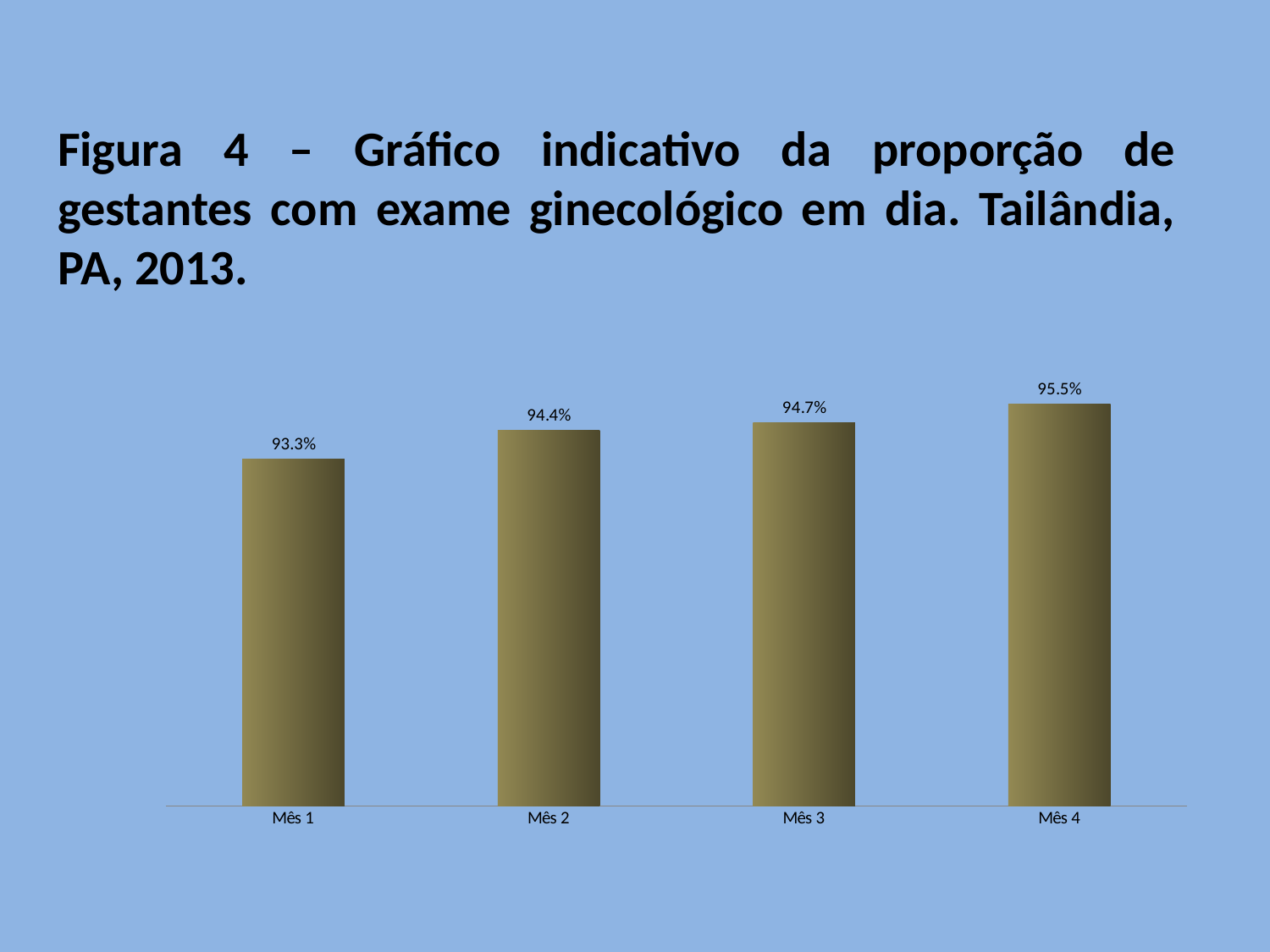
What is the difference between the values for Mês 3 and Mês 2? 0.3% What is the value for Mês 2? 94.4% How many months are shown on the x axis? 4 What is the difference between the values for Mês 4 and Mês 1? 2.2% What is the value for Mês 4? 95.5% What is the value for Mês 1? 93.3% What kind of chart is shown on the slide? Bar chart Do the values rise or fall from Mês 1 to Mês 4? Rise Which is larger, the value for Mês 2 or the value for Mês 4? Mês 4 What is the value for Mês 3? 94.7% Which month has the highest value? Mês 4 Which month has the lowest value? Mês 1